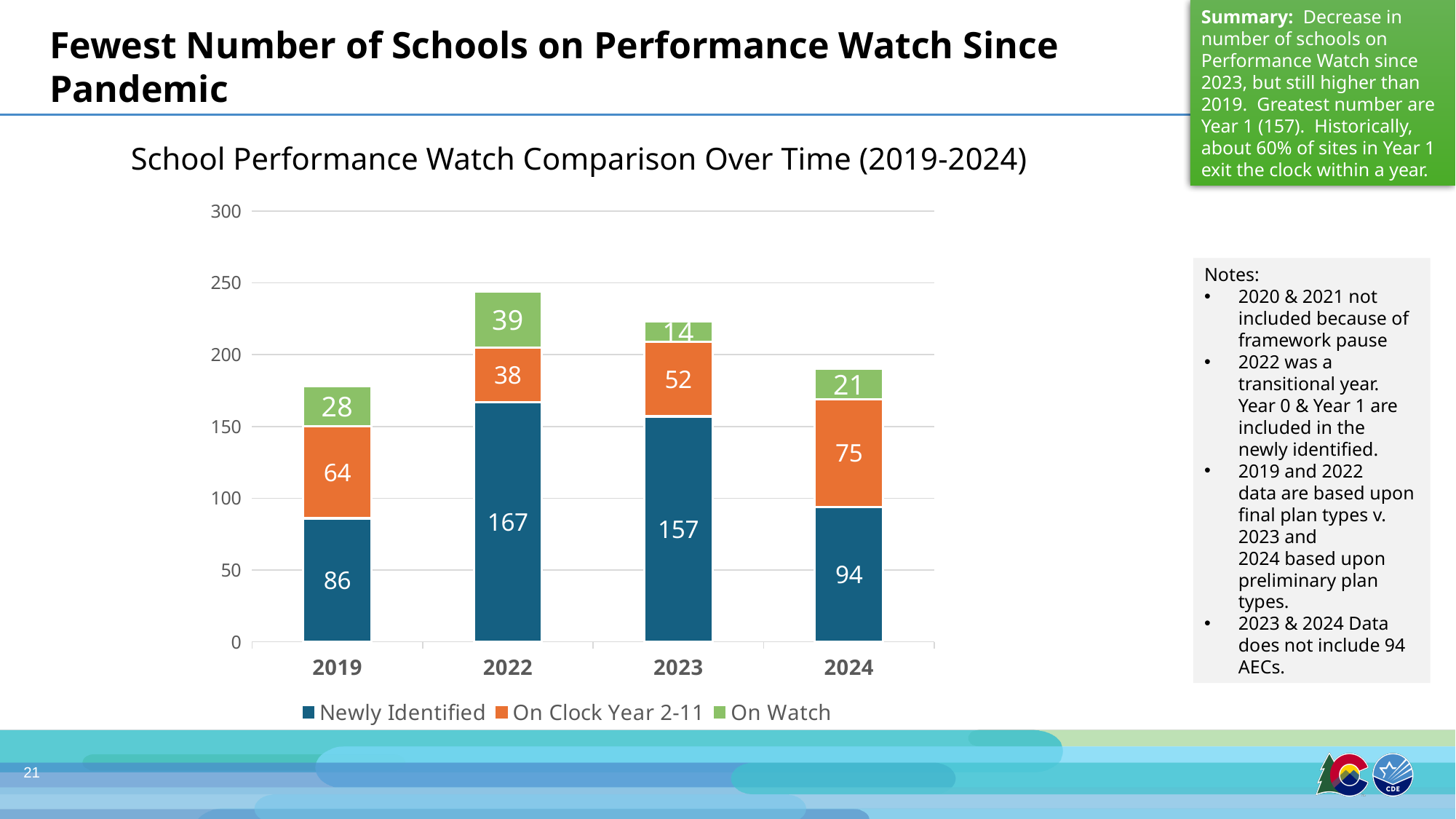
What is the On Clock Year 2-11 value for 2024? 75 What is the On Watch value for 2023? 14 Which is larger, the Newly Identified value for 2019 or for 2024? 2024 What kind of chart is shown on the slide? Stacked bar chart Which year has the lowest On Watch value? 2023 How many series does the legend list? 3 What is the Newly Identified value for 2022? 167 Which year has the highest Newly Identified value? 2022 How many years are shown on the x axis? 4 What is the difference between the On Clock Year 2-11 values for 2024 and 2022? 37 What is the total of the stacked bar for 2022? 244 What is the total of the stacked bar for 2019? 178